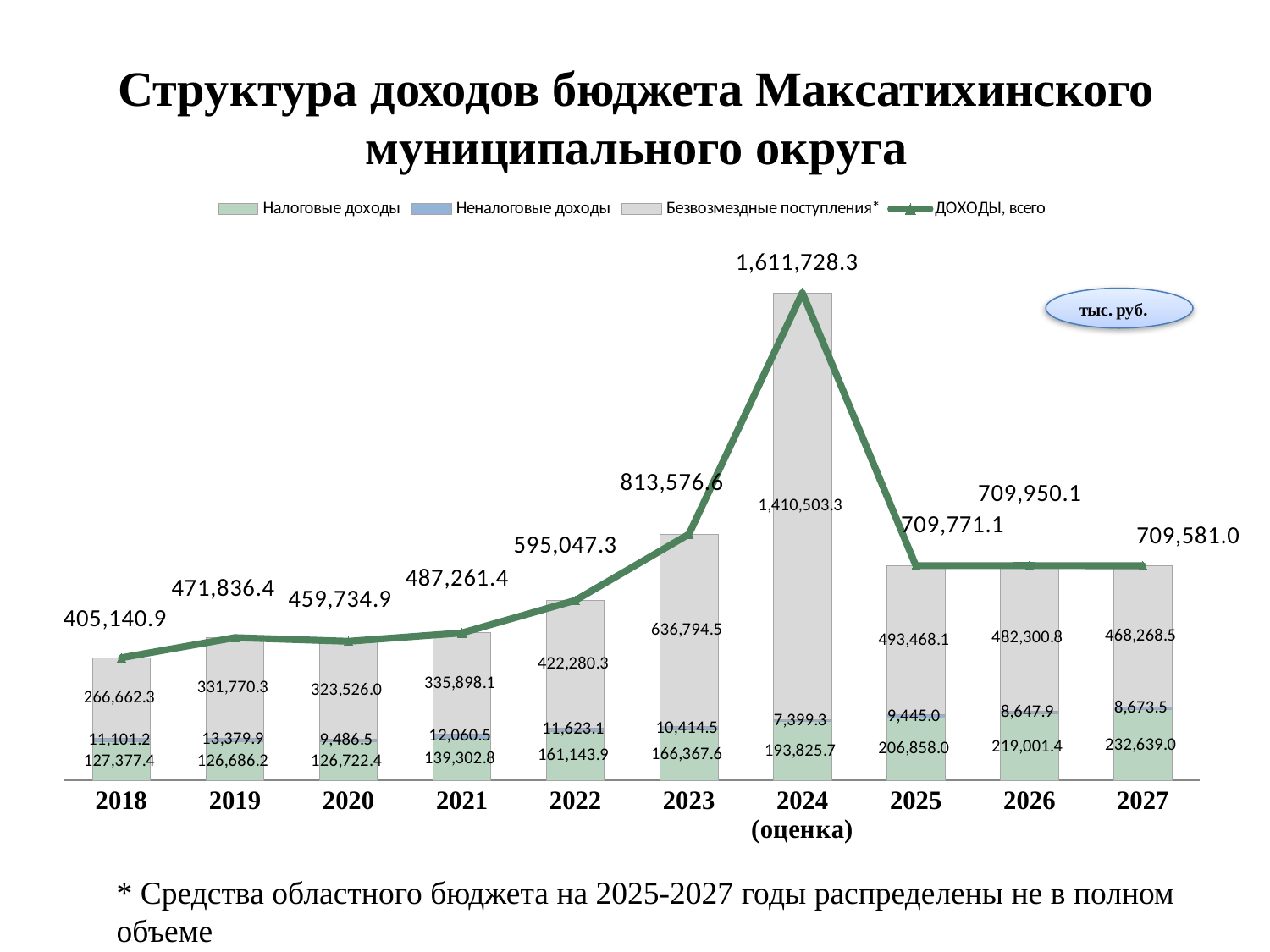
How many series does the legend list? 4 Does ДОХОДЫ, всего rise or fall from 2021 to 2024? Rise Which year has the larger value of Налоговые доходы, 2021 or 2022? 2022 What is the difference between ДОХОДЫ, всего in 2024 and in 2023? 798,151.7 Which year has the highest value of ДОХОДЫ, всего? 2024 (оценка) How many years are shown on the x axis of the chart? 10 What is the value of ДОХОДЫ, всего for 2024 (оценка)? 1,611,728.3 What is the value of Безвозмездные поступления for 2023? 636,794.5 Which year has the lowest value of ДОХОДЫ, всего? 2018 What kind of chart is shown on the slide? Stacked bar chart with a line What is the value of Налоговые доходы for 2027? 232,639.0 What is the value of Неналоговые доходы for 2019? 13,379.9